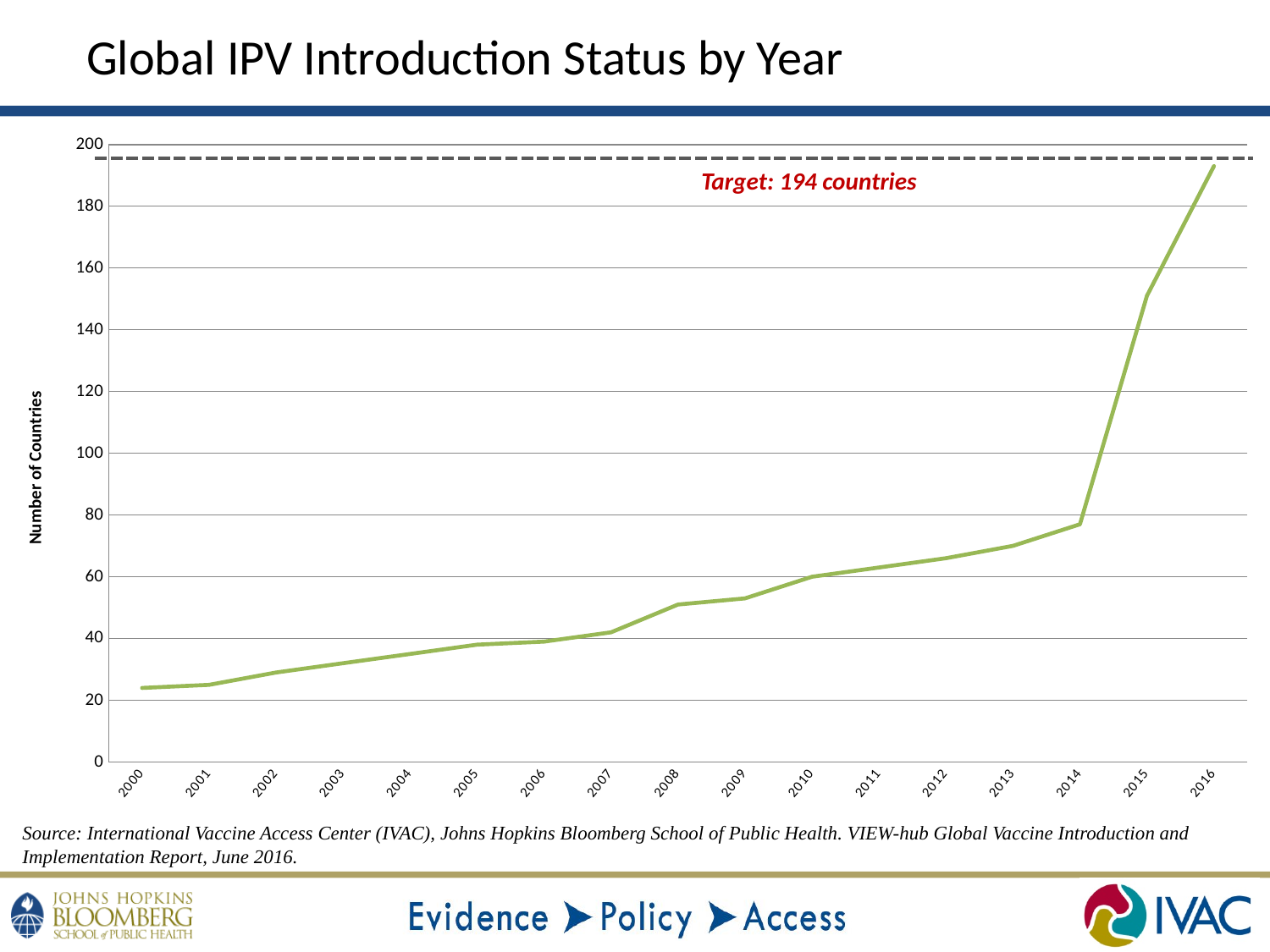
Do the values rise or fall from 2000 to 2016? rise Is the value for 2015 greater or less than 140? greater Is the value for 2000 greater or less than 40? less What kind of chart is shown on the slide? line chart What target number of countries is marked by the dashed line? 194 countries Which year has the highest number of countries? 2016 Which year has the larger value, 2014 or 2015? 2015 Is the value for 2016 greater or less than 180? greater How many years are plotted along the x axis? 17 Which year has the lowest number of countries? 2000